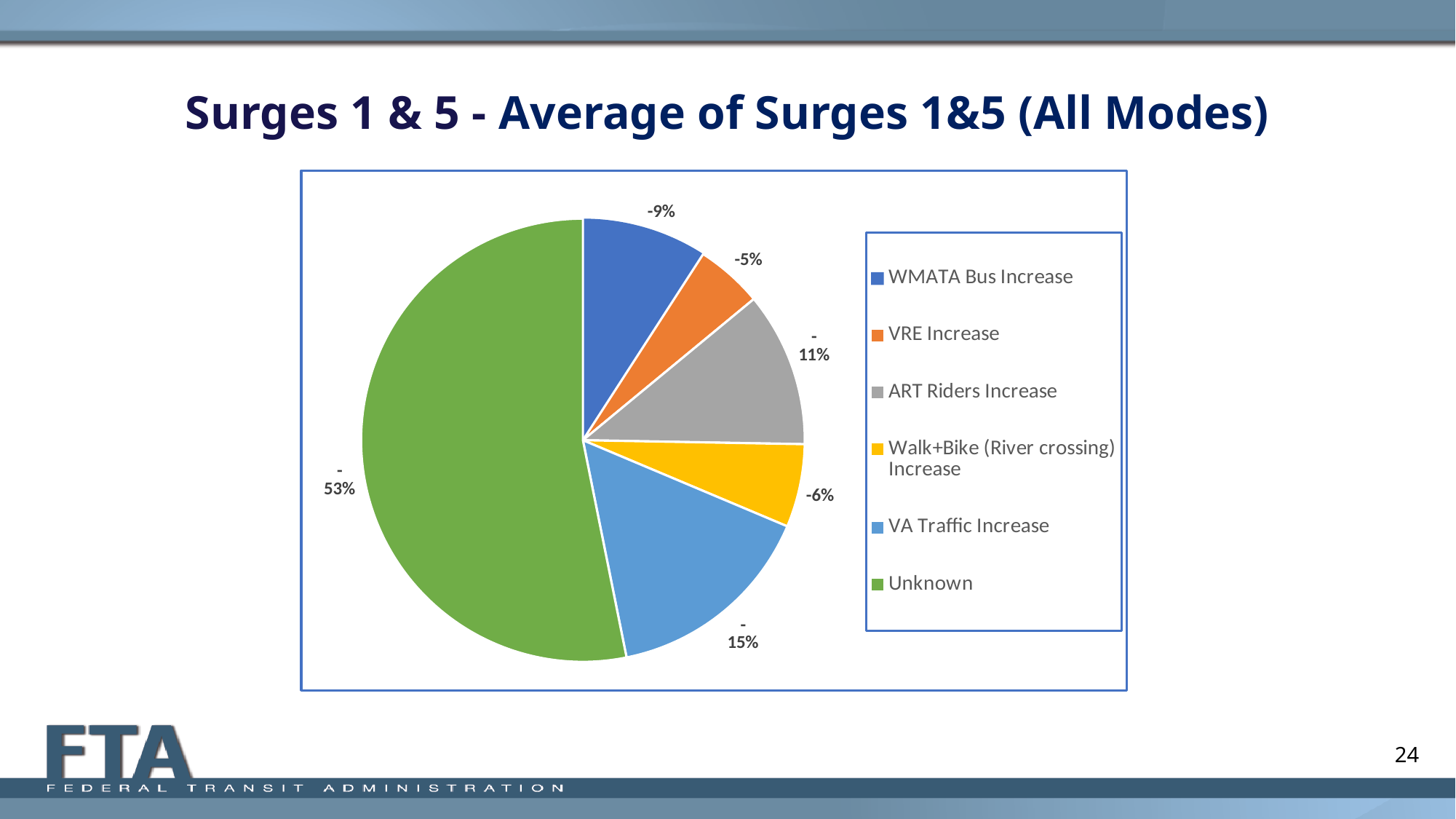
What is the data label on the ART Riders Increase slice? -11% What is the title of the chart? Surges 1 & 5 - Average of Surges 1&5 (All Modes) What type of chart is shown on the slide? pie chart What is the data label on the VRE Increase slice? -5% What is the data label on the Walk+Bike (River crossing) Increase slice? -6% Which category has the largest slice of the pie? Unknown How many entries does the legend list? 6 What is the data label on the Unknown slice? -53% What is the data label on the WMATA Bus Increase slice? -9% What is the data label on the VA Traffic Increase slice? -15% How many slices does the pie chart have? 6 Which category has the smallest slice of the pie? VRE Increase